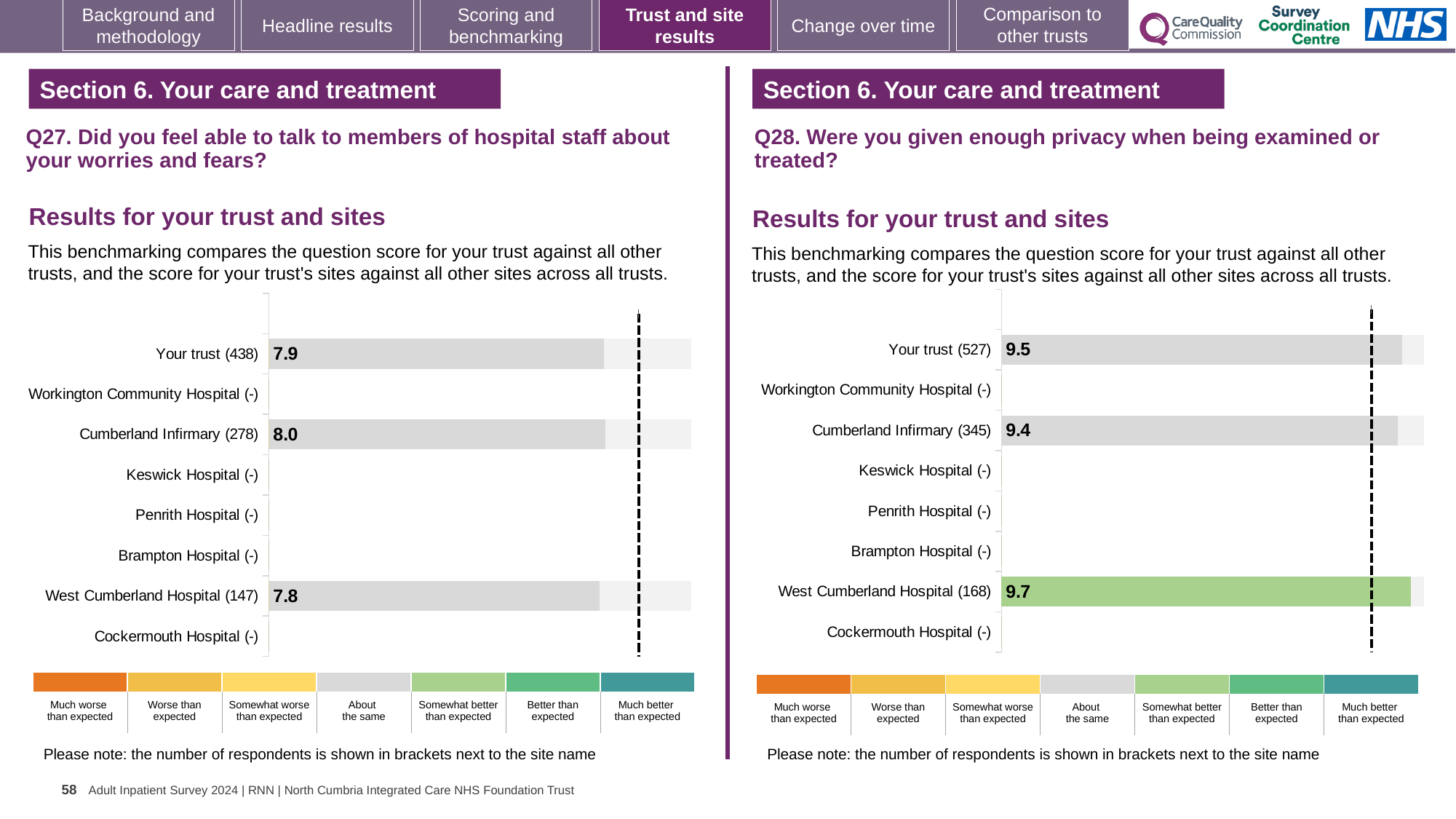
In the Q27 chart on the left, what is the score for West Cumberland Hospital? 7.8 In the Q28 chart on the right, which is larger: the score for Your trust or the score for Cumberland Infirmary? Your trust In the Q28 chart on the right, what is the score for West Cumberland Hospital? 9.7 In the Q28 chart on the right, what is the difference between the scores for West Cumberland Hospital and Cumberland Infirmary? 0.3 What kind of chart is used for the Q28 results on the right? Bar chart In the Q28 chart on the right, which site with a printed score has the highest score? West Cumberland Hospital How many site rows (including Your trust) are listed in the Q27 chart on the left? 8 In the Q27 chart on the left, what is the score for Cumberland Infirmary? 8.0 In the Q28 chart on the right, what is the score for Your trust? 9.5 In the Q27 chart on the left, what is the score for Your trust? 7.9 In the Q27 chart on the left, what is the difference between the scores for Cumberland Infirmary and West Cumberland Hospital? 0.2 In the Q27 chart on the left, which site with a printed score has the lowest score? West Cumberland Hospital